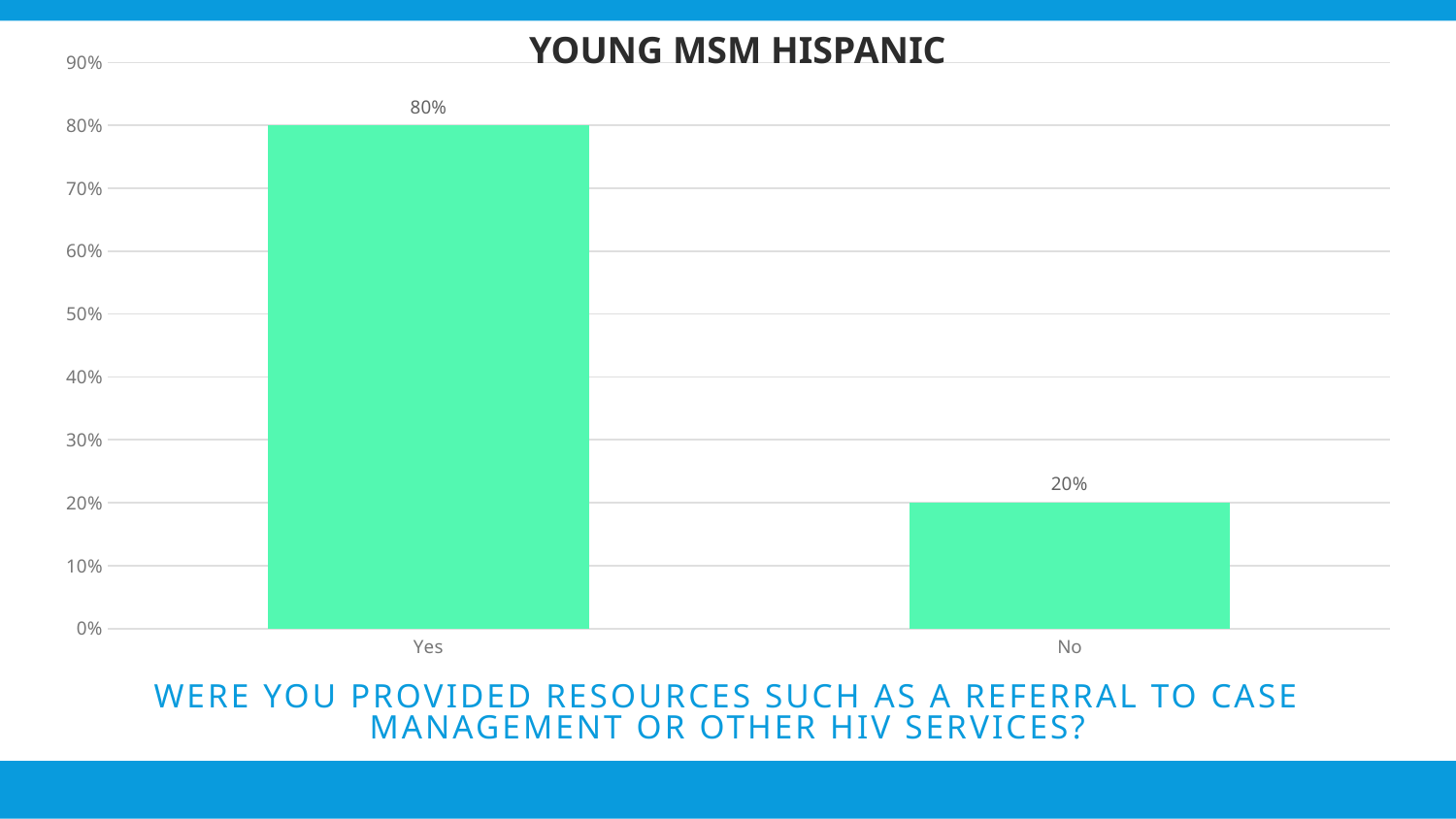
Which category has the lowest value? No What is the difference between the values for Yes and No? 60% Is the value for No greater or less than 30%? less Which category has the highest value? Yes Which is larger, the value for Yes or the value for No? Yes How many categories are shown on the x axis? 2 What is the title of the chart? YOUNG MSM HISPANIC What is the value for Yes? 80% What is the highest value shown on the y axis? 90% Is the value for Yes greater or less than 50%? greater What is the value for No? 20% What kind of chart is shown on the slide? Bar chart